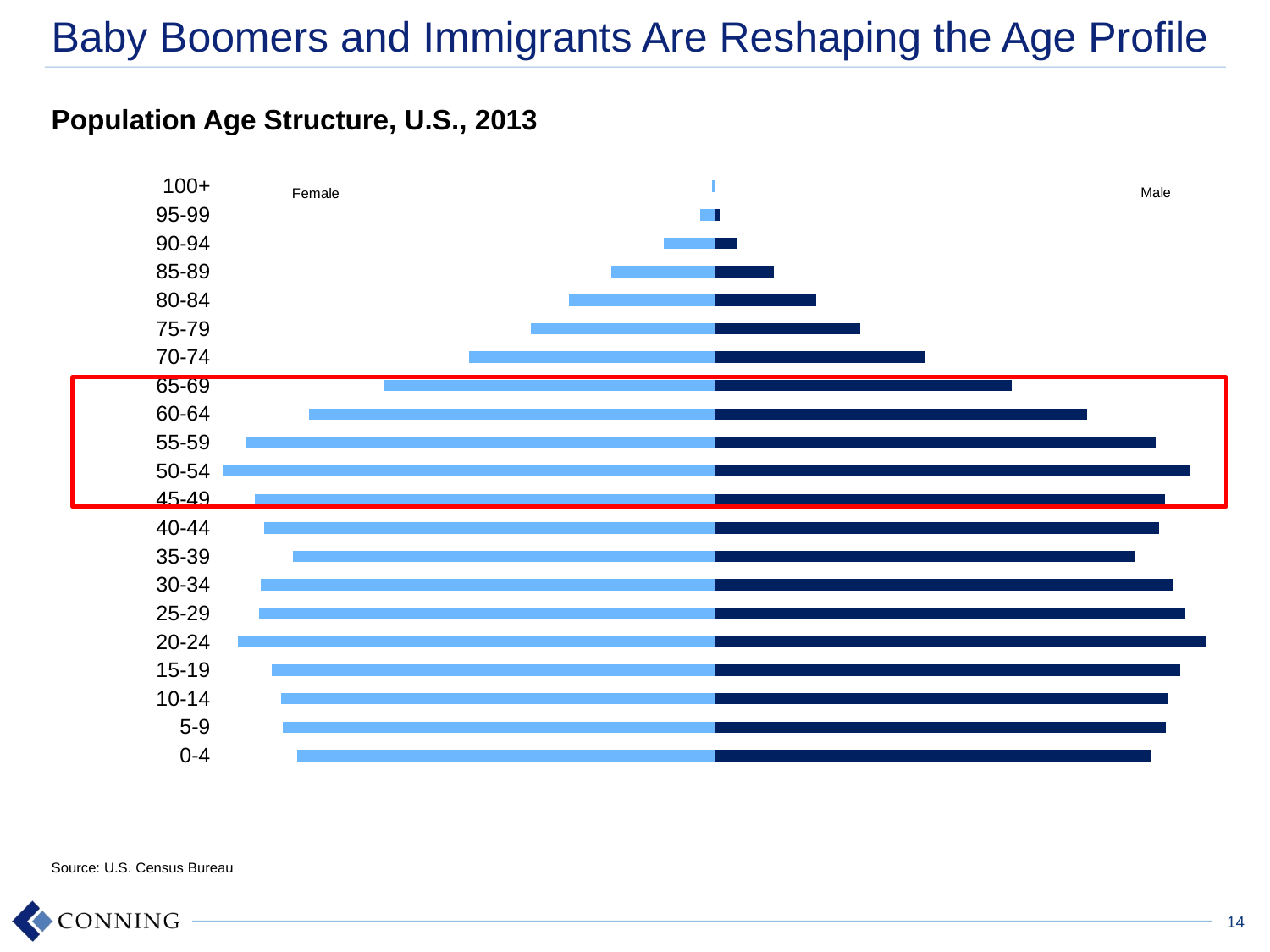
Moving from the 65-69 age group up to 100+, do the bar lengths increase or decrease? Decrease How many age groups are plotted on the chart? 21 Which age group has the longest Male bar? 20-24 Which age groups are enclosed by the red box on the chart? 45-49 through 65-69 Which age group has the longest Female bar? 50-54 How many series does the chart show? 2 Which is larger, the Female bar for 70-74 or the Female bar for 80-84? 70-74 Which age group has the shortest Female bar? 100+ Which age group has the shortest Male bar? 100+ What is the title of the chart? Population Age Structure, U.S., 2013 Which is larger, the Male bar for 20-24 or the Male bar for 0-4? 20-24 What kind of chart is shown on the slide? Bar chart (population pyramid)